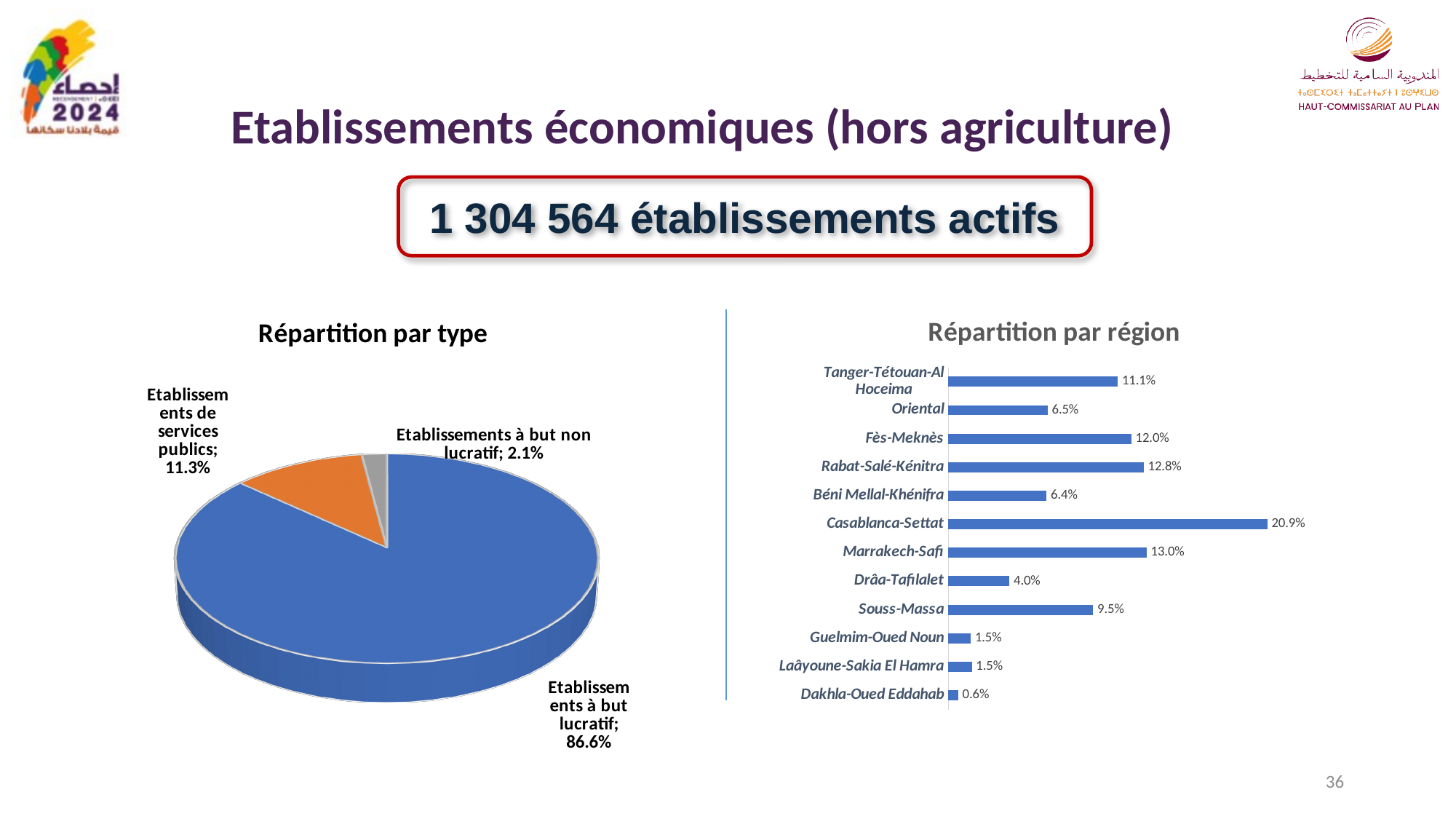
In the 'Répartition par région' chart, what is the value for Casablanca-Settat? 20.9% In the 'Répartition par type' chart, what share do Etablissements à but lucratif have? 86.6% In the 'Répartition par région' chart, which is larger, Marrakech-Safi or Fès-Meknès? Marrakech-Safi In the 'Répartition par région' chart, which region has the highest value? Casablanca-Settat What kind of chart is 'Répartition par région'? Bar chart In the 'Répartition par type' chart, which category has the smallest share? Etablissements à but non lucratif In the 'Répartition par région' chart, which region has the lowest value? Dakhla-Oued Eddahab How many regions are shown in the 'Répartition par région' chart? 12 What kind of chart is 'Répartition par type'? Pie chart In the 'Répartition par région' chart, what is the value for Souss-Massa? 9.5% In the 'Répartition par région' chart, what is the difference between Rabat-Salé-Kénitra and Oriental? 6.3% In the 'Répartition par type' chart, what share do Etablissements de services publics have? 11.3%